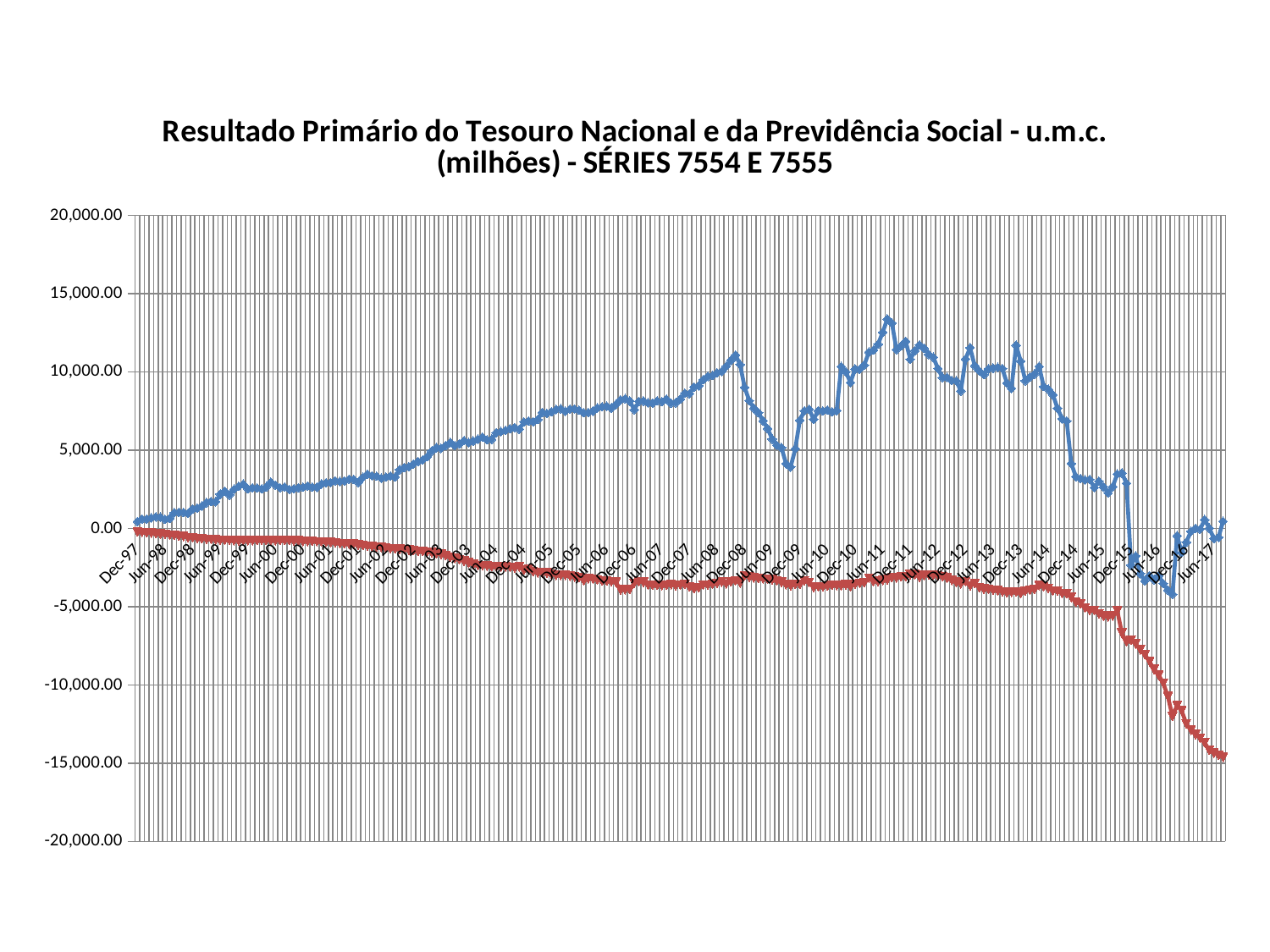
Is the value of the red series at Jun-17 greater or less than -10,000.00? less Is the value of the blue series at Dec-11 greater or less than 10,000.00? greater Around which x-axis label does the blue series reach its highest point? Jun-11 Which series has the higher value at Jun-17, the blue series or the red series? the blue series What is the highest value shown on the vertical axis? 20,000.00 Is the value of the blue series at Jun-05 greater or less than 5,000.00? greater Does the red series generally rise or fall from Dec-97 to Jun-17? fall How many data series are plotted on the chart? 2 What is the first label on the horizontal axis? Dec-97 What kind of chart is shown on the slide? line chart